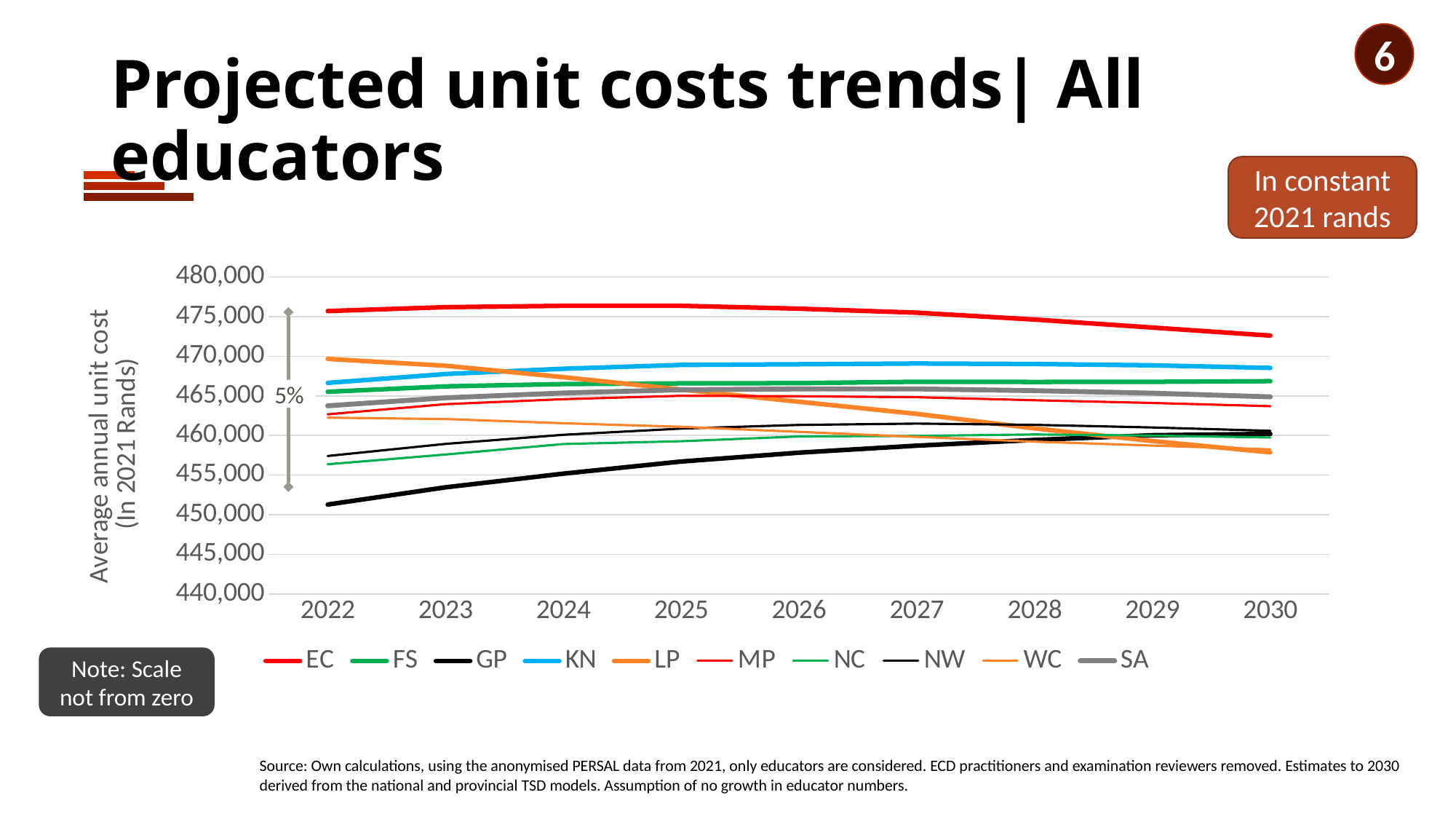
How many years are shown along the x axis? 9 Is the value for KN in 2030 greater or less than 465,000? greater What kind of chart is shown on the slide? line chart Is the value for EC in 2030 greater or less than 475,000? less Which series has the lowest average annual unit cost in 2022? GP Does the GP line rise or fall from 2022 to 2030? rise Is the value for GP in 2022 greater or less than 455,000? less Does the LP line rise or fall from 2022 to 2030? fall How many series does the legend list? 10 In 2022, which is larger, the value for LP or the value for WC? LP Which series has the highest average annual unit cost in 2022? EC What is the y-axis title of the chart? Average annual unit cost (In 2021 Rands)